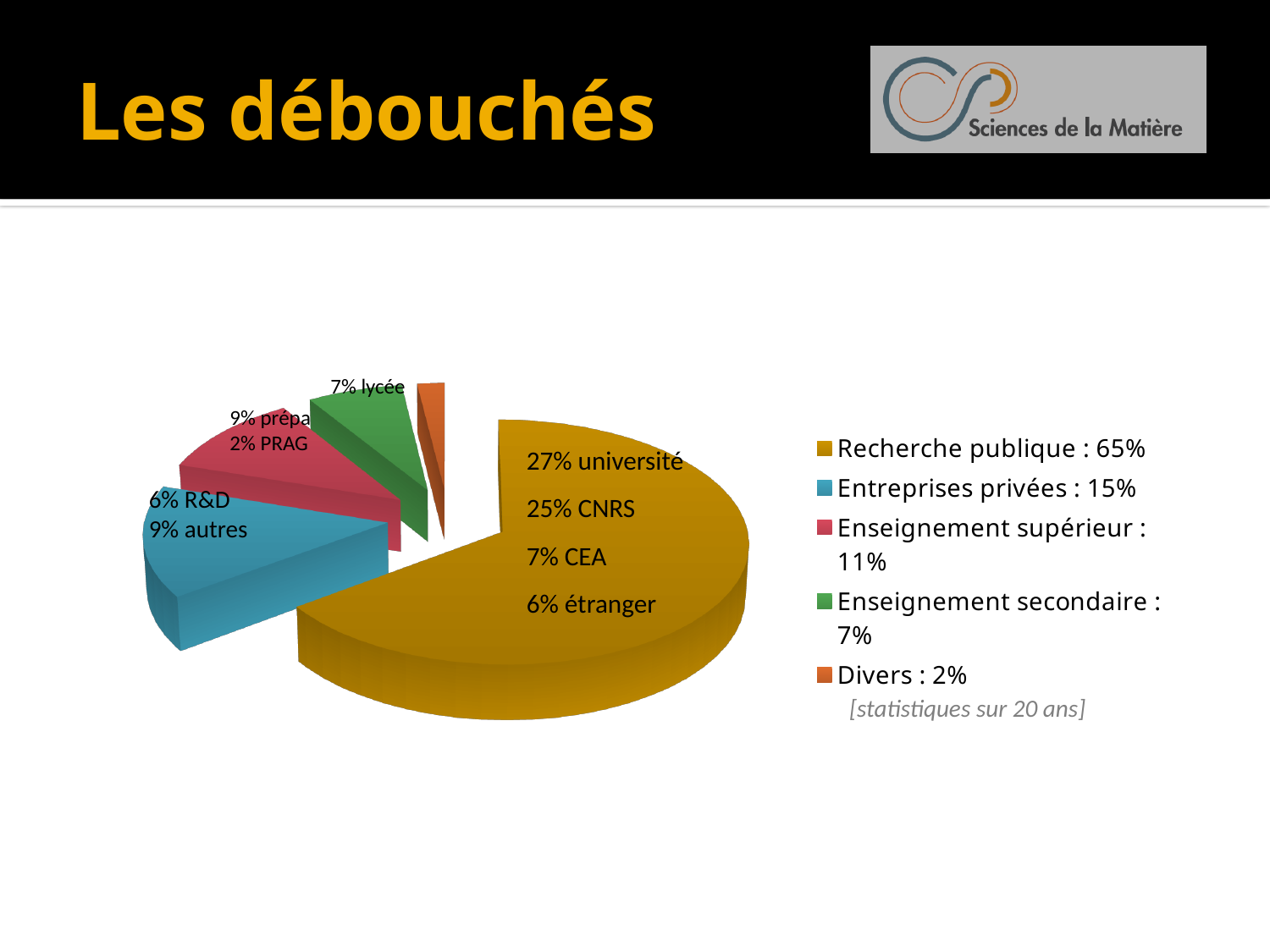
What colour is the Entreprises privées slice? blue Within the Recherche publique slice, what percentage is labelled CNRS? 25% What is the value for Divers? 2% What kind of chart is shown on the slide? pie chart How many categories does the legend list? 5 Which category has the largest slice of the pie? Recherche publique What is the value for Enseignement supérieur? 11% What is the difference between Recherche publique and Entreprises privées? 50% What is the value for Entreprises privées? 15% Which is larger, Enseignement supérieur or Enseignement secondaire? Enseignement supérieur What share of the pie does Recherche publique represent? 65% Which category has the smallest slice of the pie? Divers